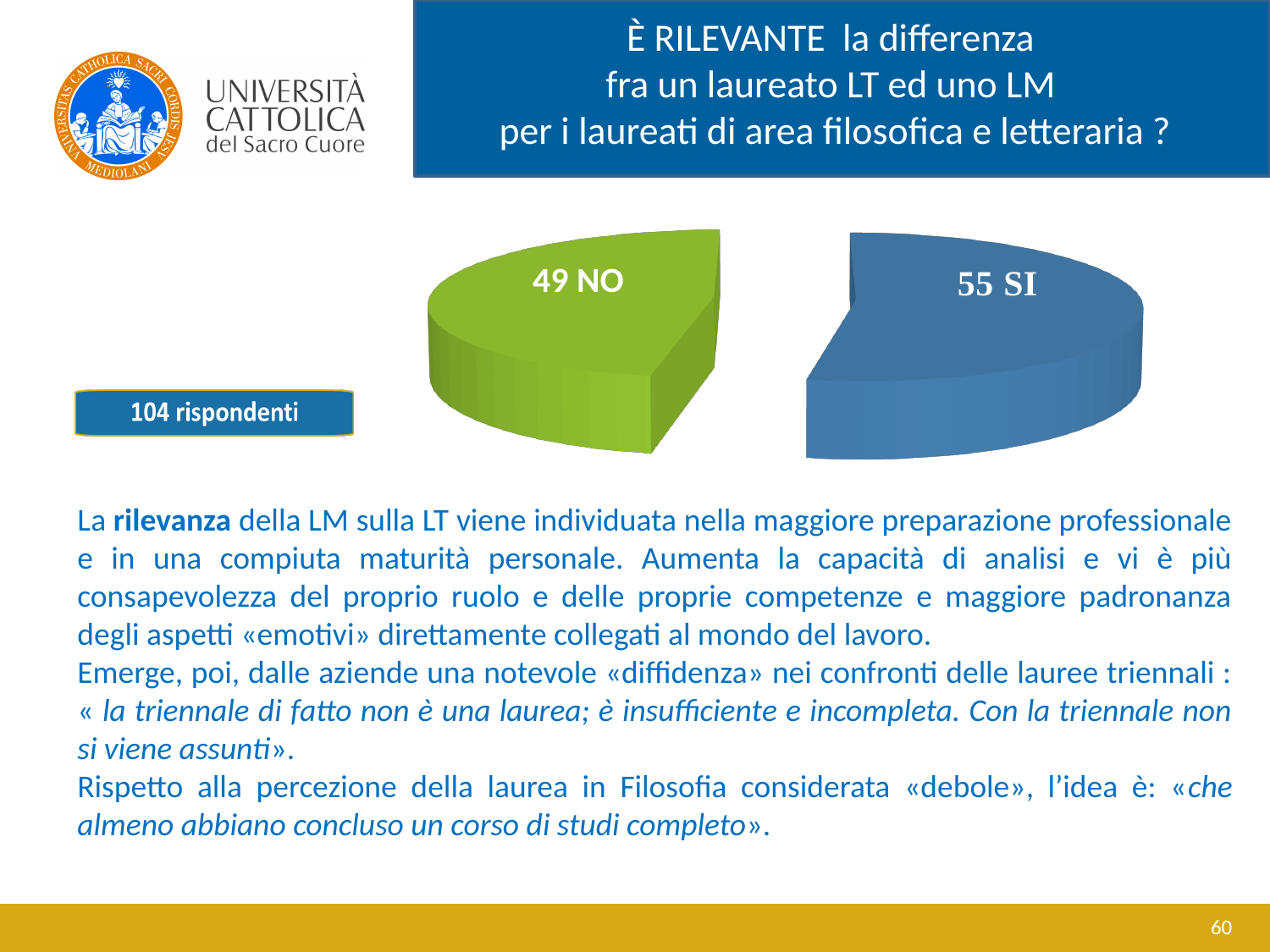
How many slices does the pie chart have? 2 How many respondents answered NO? 49 Which answer has the larger slice of the pie, SI or NO? SI What colour is the NO slice of the pie chart? Green What is the difference between the number of SI and NO answers? 6 What is the total number of respondents shown in the pie chart? 104 What kind of chart is shown on the slide? Pie chart Which answer has the smallest slice of the pie? NO What colour is the SI slice of the pie chart? Blue Which answer has the largest slice of the pie? SI Is the number of SI answers greater or less than 50? greater How many respondents answered SI? 55